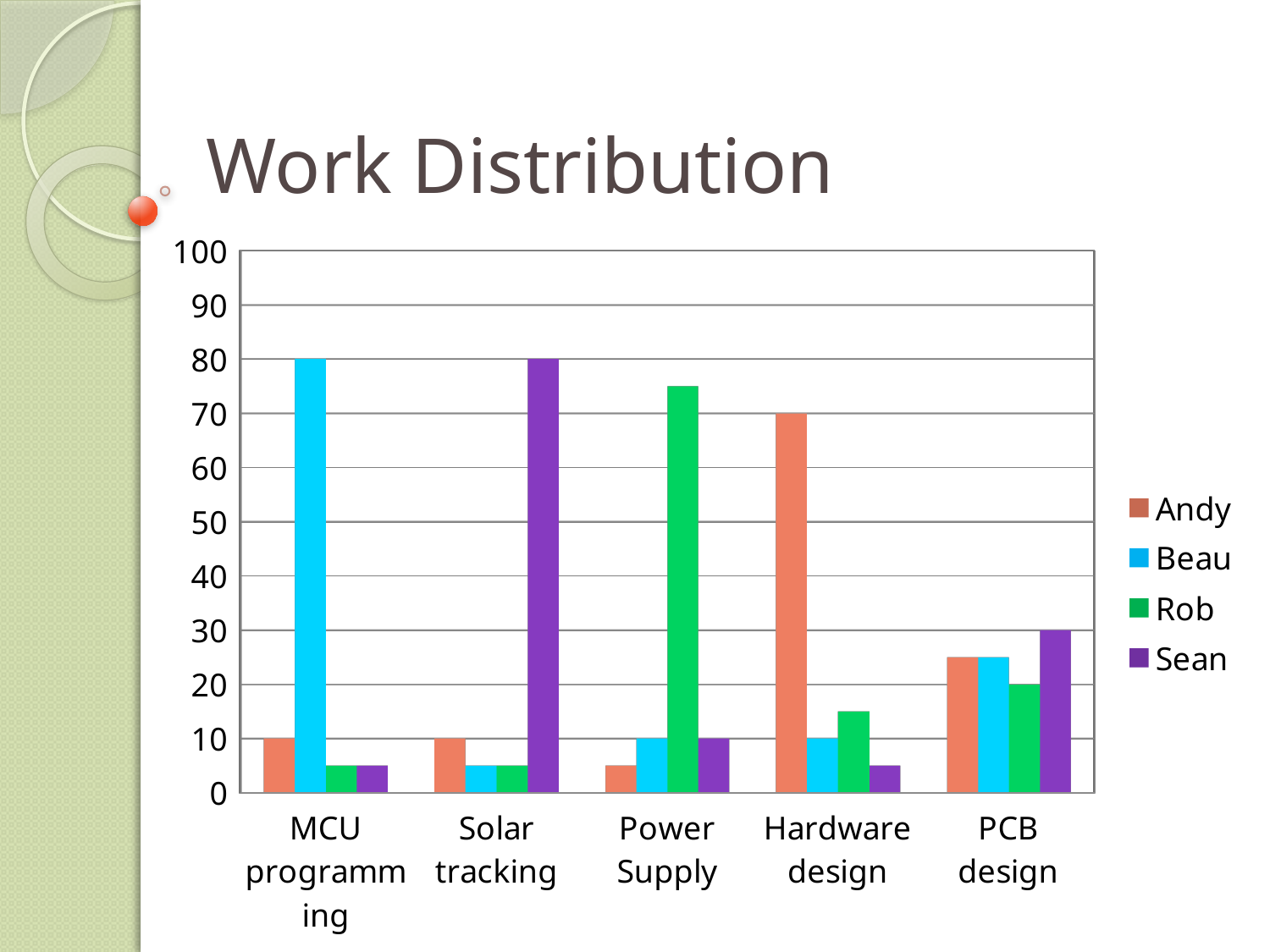
How many series does the legend list? 4 What is the difference between Sean's and Rob's values in PCB design? 10 How many categories are shown on the x axis? 5 Which person has the highest value for Power Supply? Rob What is the value for Andy in Hardware design? 70 What is the value for Sean in PCB design? 30 What is the value for Beau in MCU programming? 80 What is the title of the chart? Work Distribution What type of chart is shown on the slide? bar chart Is the value for Rob in Power Supply greater or less than 70? greater Which person has the highest value for Solar tracking? Sean Which is larger: Beau's value in MCU programming or Andy's value in Hardware design? Beau's value in MCU programming